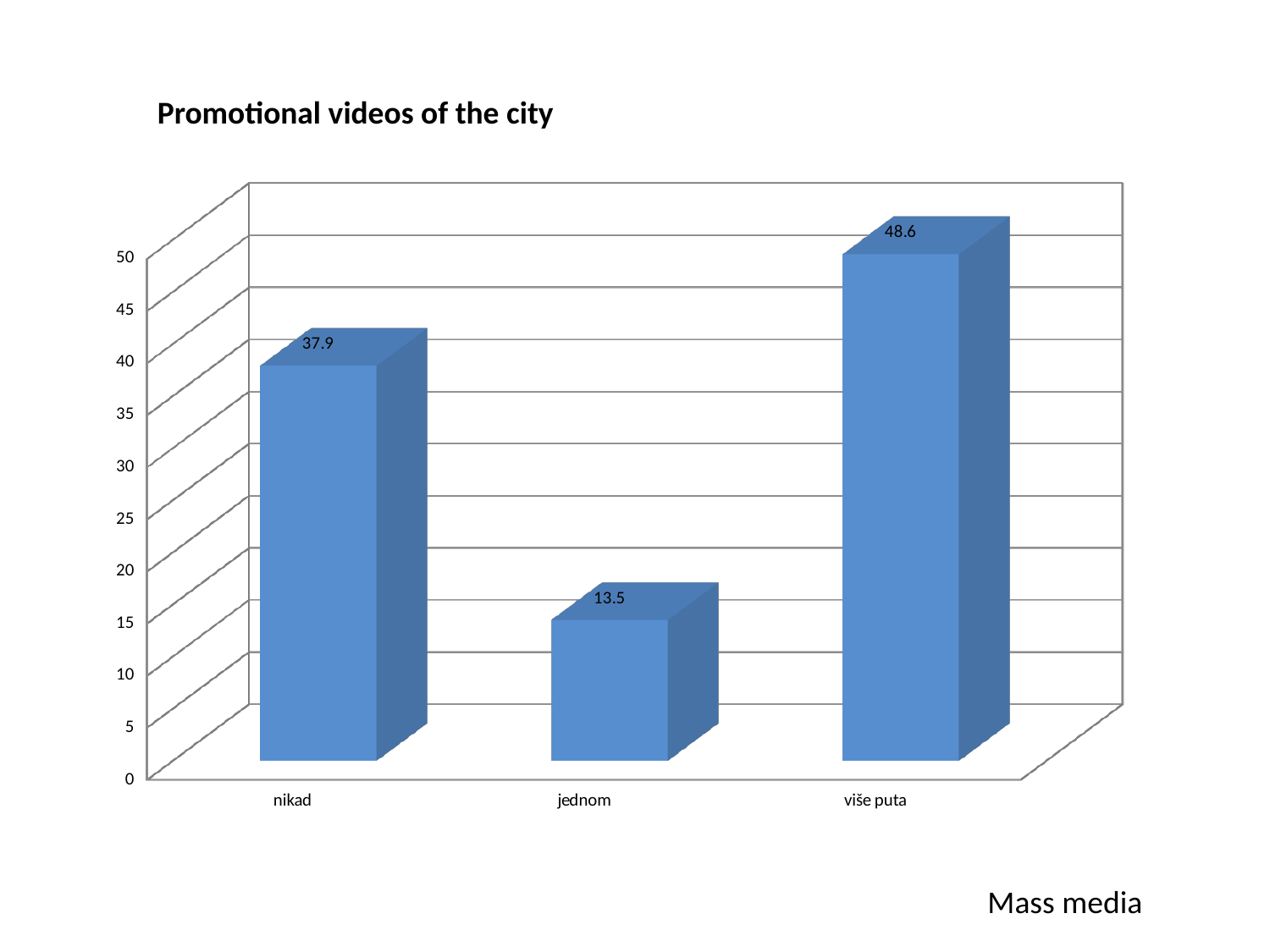
Which is larger, the value for nikad or the value for jednom? nikad Which category has the highest value? više puta What is the value for jednom? 13.5 What is the difference between the values for nikad and jednom? 24.4 What is the value for nikad? 37.9 Is the value for jednom greater or less than 20? less How many categories are shown on the x axis? 3 What kind of chart is shown on the slide? bar chart Which category has the lowest value? jednom What is the difference between the values for više puta and nikad? 10.7 What is the title of the chart? Promotional videos of the city What is the value for više puta? 48.6